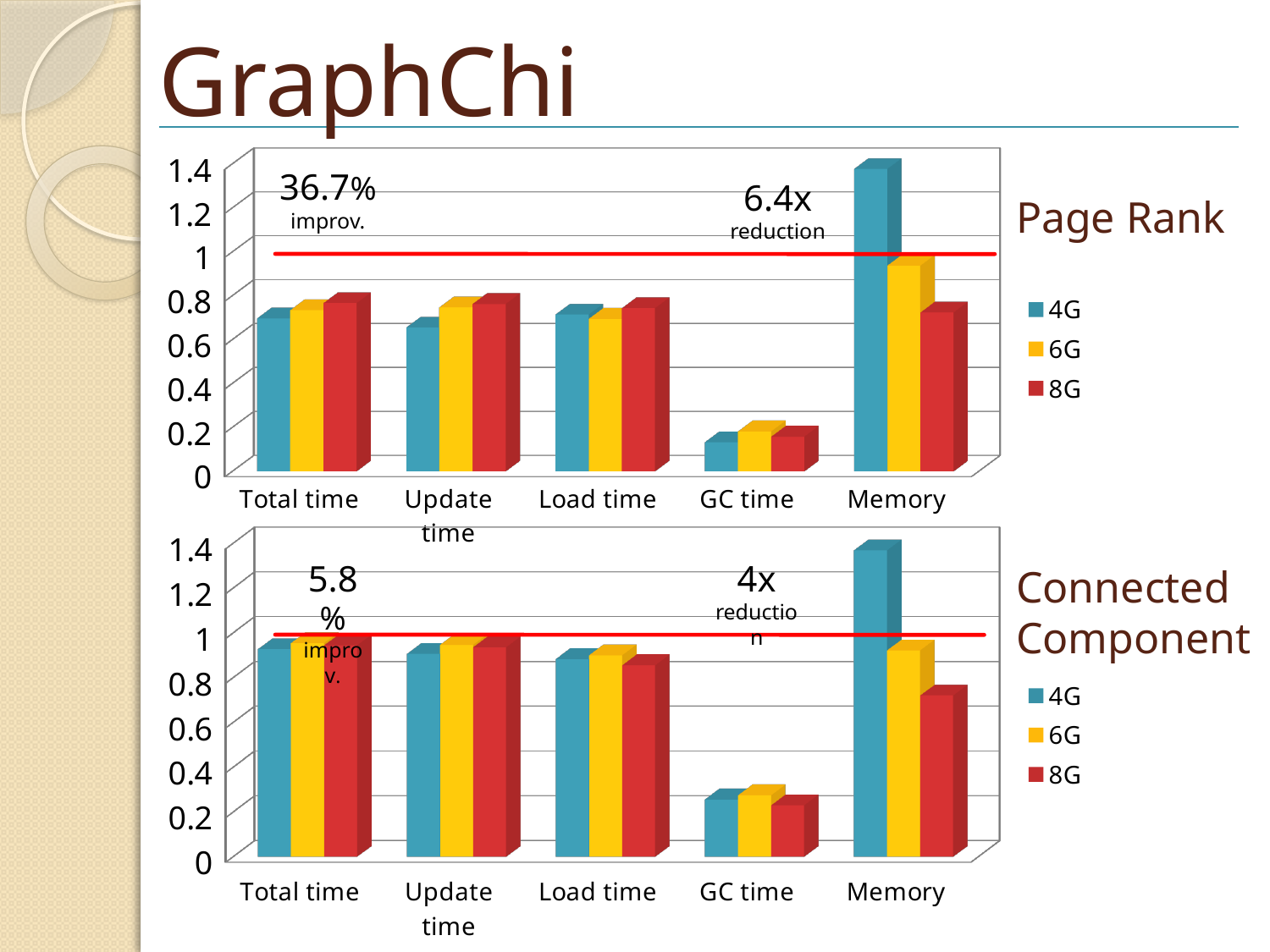
In the Page Rank chart, is the 4G value for GC time greater or less than 0.2? less In the Page Rank chart, is the 4G value for Memory greater or less than 1.2? greater What kind of chart is the Page Rank chart? bar chart How many series does the legend of the Page Rank chart list? 3 What reduction factor is annotated above the Memory bars in the Connected Component chart? 4x reduction How many categories are shown on the x axis of the Connected Component chart? 5 In the Page Rank chart, which category has the tallest 4G bar? Memory In the Page Rank chart, for Memory, which is larger: the 4G bar or the 8G bar? 4G In the Connected Component chart, for Memory, which is larger: the 6G bar or the 8G bar? 6G In the Connected Component chart, is the 4G value for Total time greater or less than 1? less In the Page Rank chart, which category has the shortest bars overall? GC time